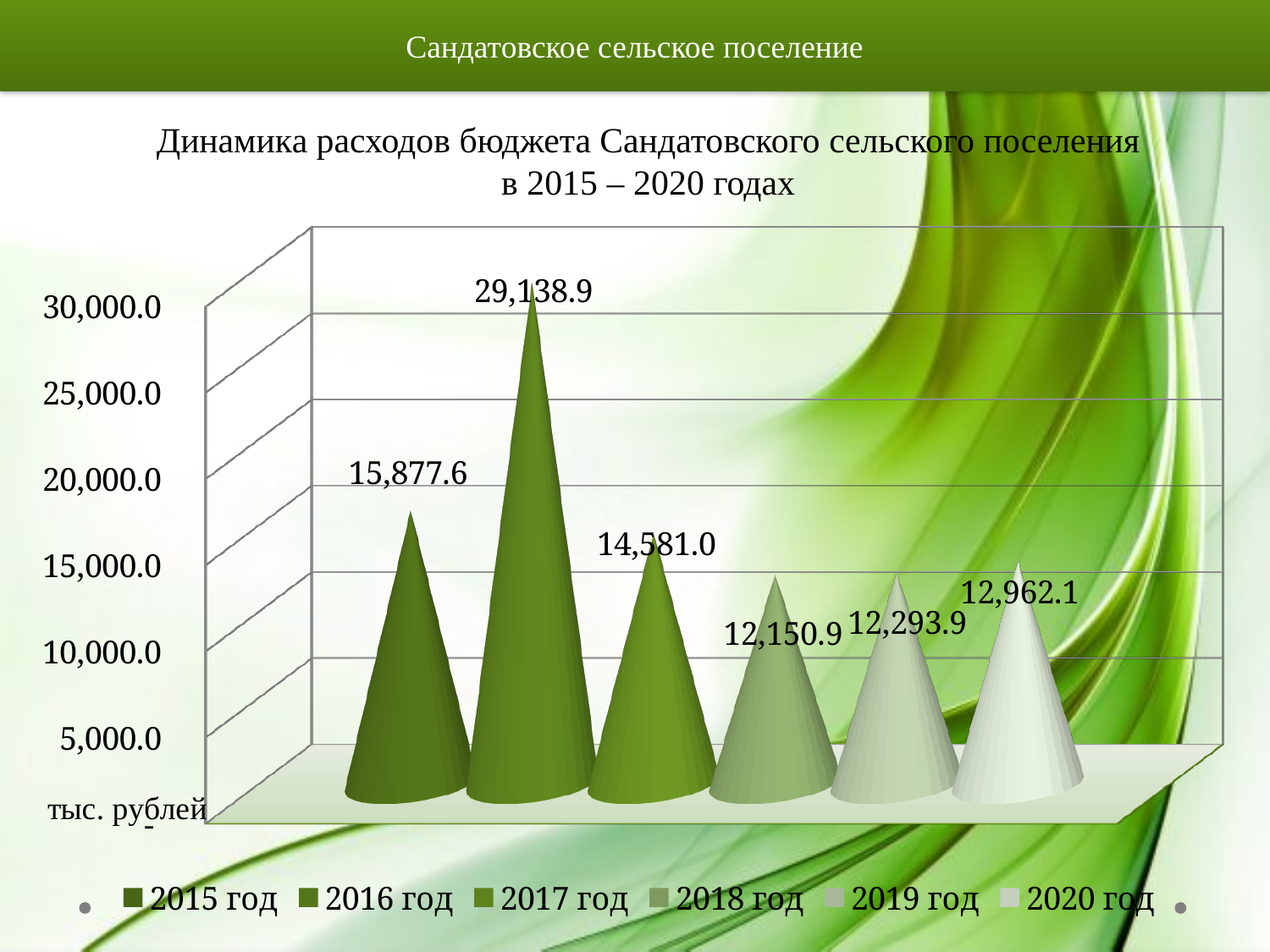
Which is larger, the value for 2015 год or the value for 2017 год? 2015 год What unit of measurement is indicated on the chart? тыс. рублей What is the value shown for 2018 год? 12,150.9 What is the budget expenditure value shown for 2016 год? 29,138.9 What is the difference between the values for 2016 год and 2015 год? 13,261.3 How many entries does the legend list? 6 Is the value for 2017 год greater or less than 15,000.0? less What is the value shown for 2020 год? 12,962.1 What is the difference between the values for 2020 год and 2019 год? 668.2 Which year has the lowest expenditure value? 2018 год How many years are plotted on the chart? 6 Which year has the highest expenditure value? 2016 год